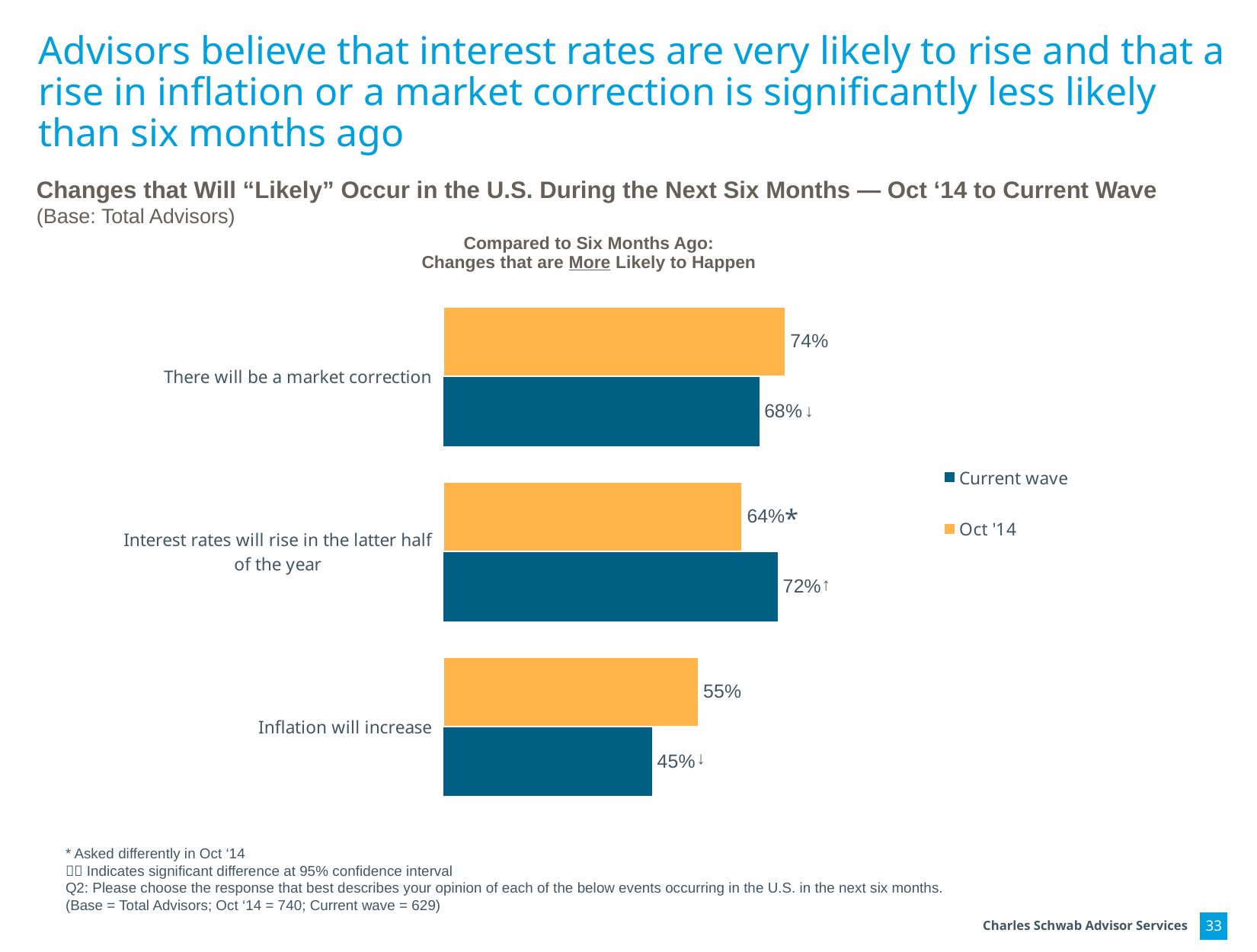
For "Interest rates will rise in the latter half of the year", which is larger: the Current wave value or the Oct '14 value? Current wave How many categories are plotted in the chart? 3 Which legend entry is shown in orange? Oct '14 Which category has the lowest Current wave value? Inflation will increase What is the Oct '14 value for "Interest rates will rise in the latter half of the year"? 64% What kind of chart is shown on the slide? bar chart Which category has the highest Oct '14 value? There will be a market correction How many series does the legend list? 2 What is the Current wave value for "There will be a market correction"? 68% What is the Current wave value for "Inflation will increase"? 45% What is the difference between the Oct '14 and Current wave values for "Inflation will increase"? 10 percentage points What is the difference between the Oct '14 and Current wave values for "There will be a market correction"? 6 percentage points